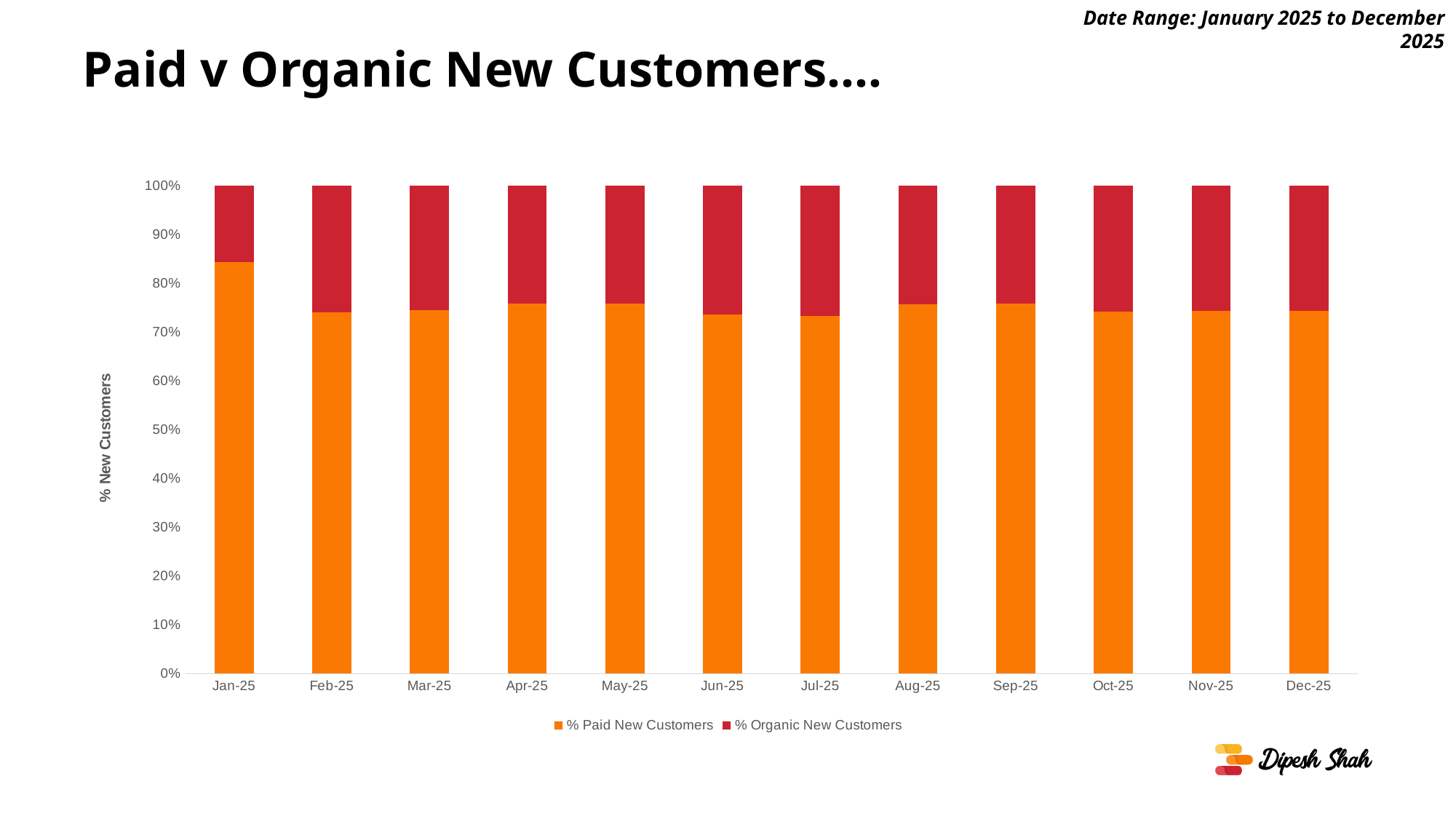
Is the value for % Paid New Customers in Jan-25 greater or less than 80%? greater What is the label on the vertical axis of the chart? % New Customers Which month has the highest share of % Paid New Customers? Jan-25 Which is larger, the % Paid New Customers in Jan-25 or in Apr-25? Jan-25 How many series does the chart legend list? 2 Is the value for % Paid New Customers in Feb-25 greater or less than 80%? less What are the two series listed in the chart legend? % Paid New Customers and % Organic New Customers What is the total height of the stacked bar for Jan-25? 100% Is the value for % Paid New Customers in Jul-25 greater or less than 70%? greater What kind of chart is shown on the slide? Stacked bar chart How many months are shown on the x axis of the chart? 12 Which month has the lowest share of % Organic New Customers? Jan-25